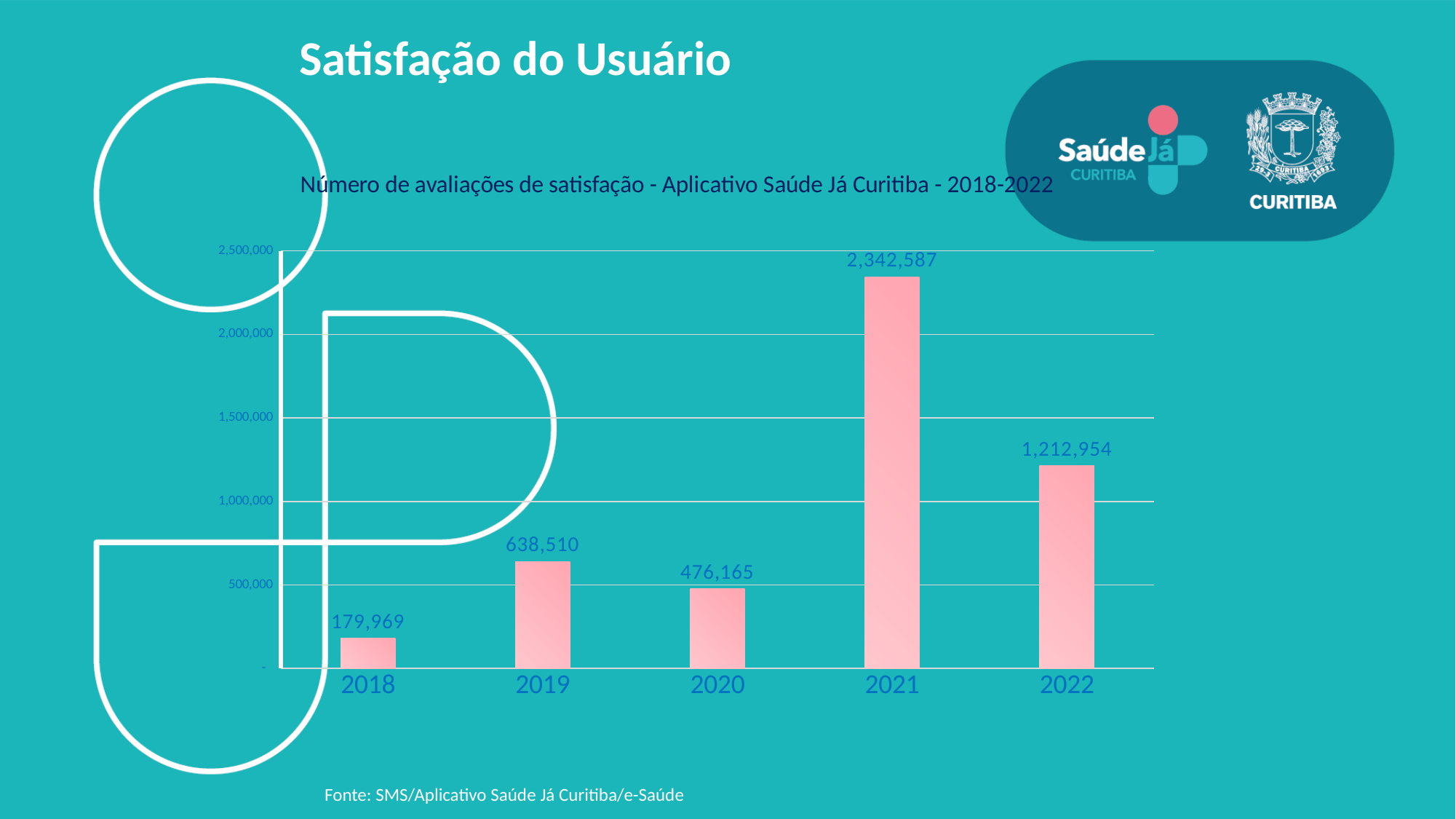
Is the value for 2022 greater or less than 1,000,000? greater What is the difference between the values for 2019 and 2020? 162,345 Which year has the highest number of satisfaction evaluations? 2021 Which year has the lowest number of satisfaction evaluations? 2018 Which year has a larger value, 2019 or 2020? 2019 What kind of chart is shown on the slide? bar chart How many years are shown on the x axis of the chart? 5 What is the number of satisfaction evaluations for 2018? 179,969 What is the number of satisfaction evaluations for 2021? 2,342,587 What is the value shown for 2020? 476,165 What is the title of the chart? Número de avaliações de satisfação - Aplicativo Saúde Já Curitiba - 2018-2022 What is the difference between the values for 2021 and 2022? 1,129,633